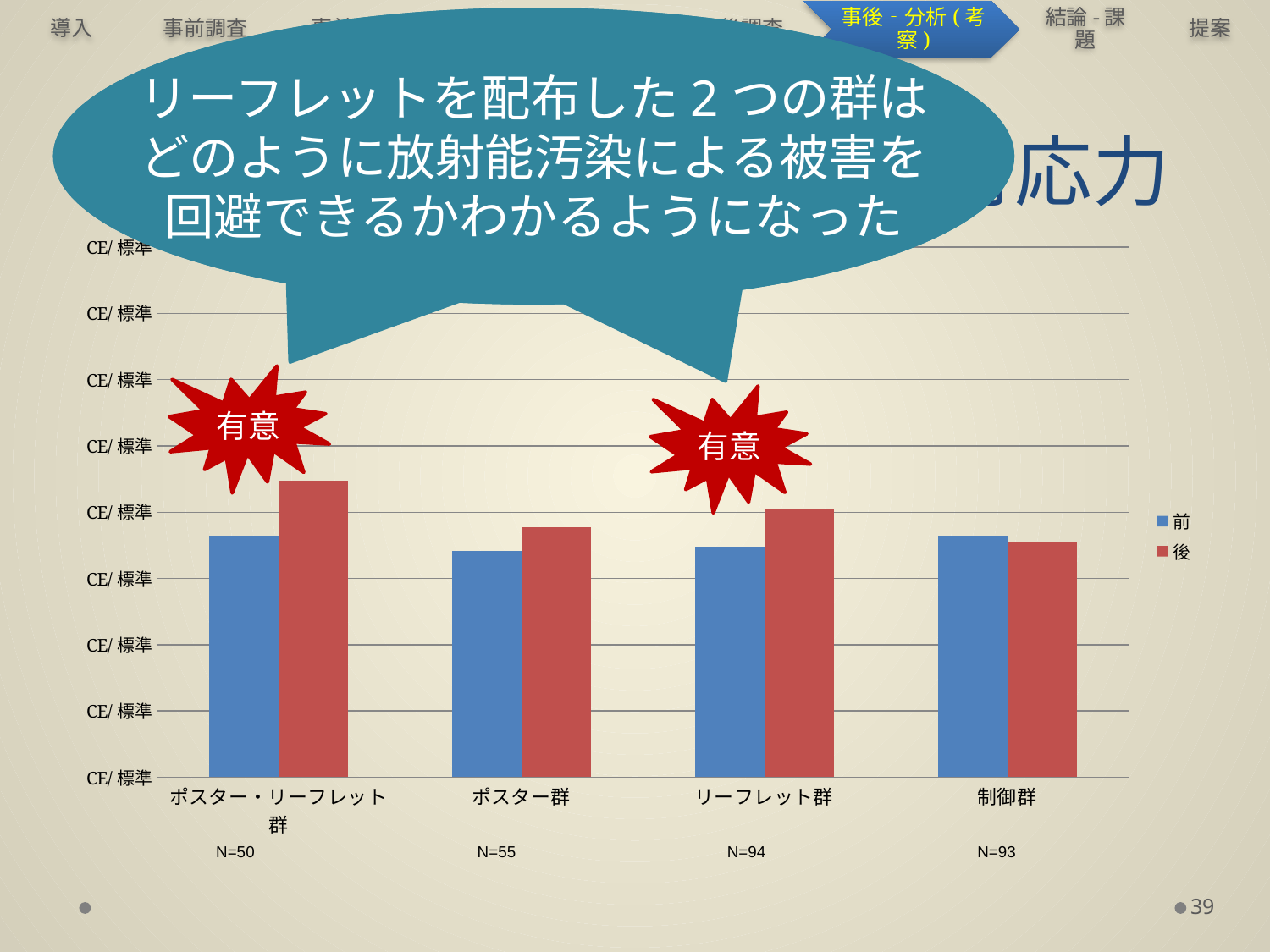
For ポスター群, which is larger: the 前 bar or the 後 bar? 後 What are the two series listed in the chart's legend? 前 and 後 Which series is drawn in red in the chart? 後 Which group has the lowest 後 bar in the chart? 制御群 Which group's 後 bar is higher: ポスター群 or ポスター・リーフレット群? ポスター・リーフレット群 For リーフレット群, which is larger: the 前 bar or the 後 bar? 後 How many series does the chart's legend list? 2 What kind of chart is shown on the slide? bar chart How many categories (groups) are shown on the x axis of the chart? 4 Which group has the highest 後 bar in the chart? ポスター・リーフレット群